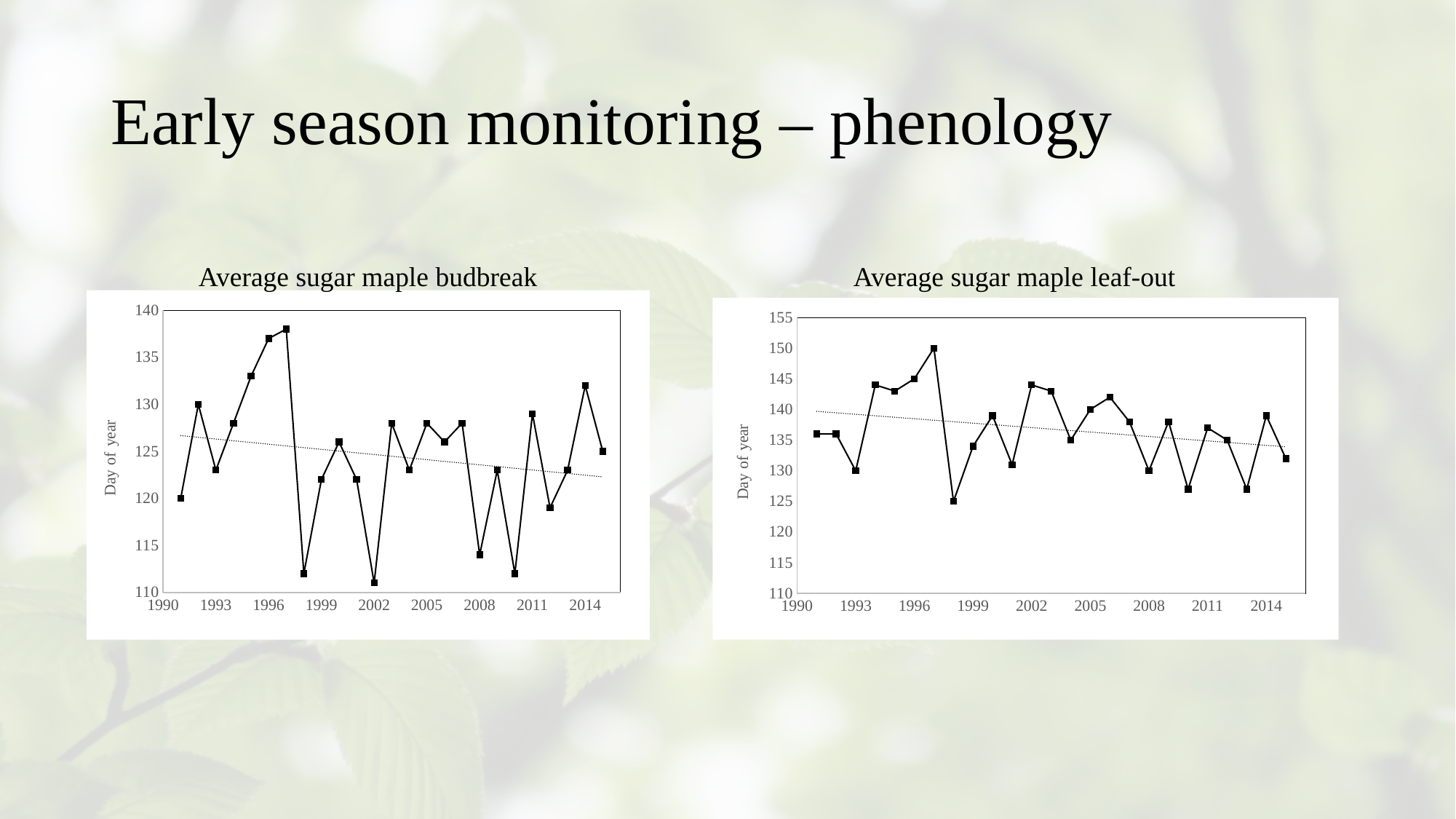
What is the y-axis label on the 'Average sugar maple leaf-out' chart? Day of year What type of chart is the 'Average sugar maple budbreak' chart? line chart In the 'Average sugar maple leaf-out' chart, which year has the highest value? 1997 In the 'Average sugar maple leaf-out' chart, which is larger, the value for 1993 or the value for 1994? 1994 In the 'Average sugar maple budbreak' chart, does the dotted trend line rise or fall from left to right? fall In the 'Average sugar maple leaf-out' chart, is the value for 1998 greater or less than 130? less In the 'Average sugar maple leaf-out' chart, is the value for 1997 greater or less than 145? greater In the 'Average sugar maple leaf-out' chart, does the dotted trend line rise or fall from left to right? fall What is the title of the chart on the left of the slide? Average sugar maple budbreak In the 'Average sugar maple budbreak' chart, is the value for 1997 greater or less than 135? greater In the 'Average sugar maple budbreak' chart, which is larger, the value for 1991 or the value for 1992? 1992